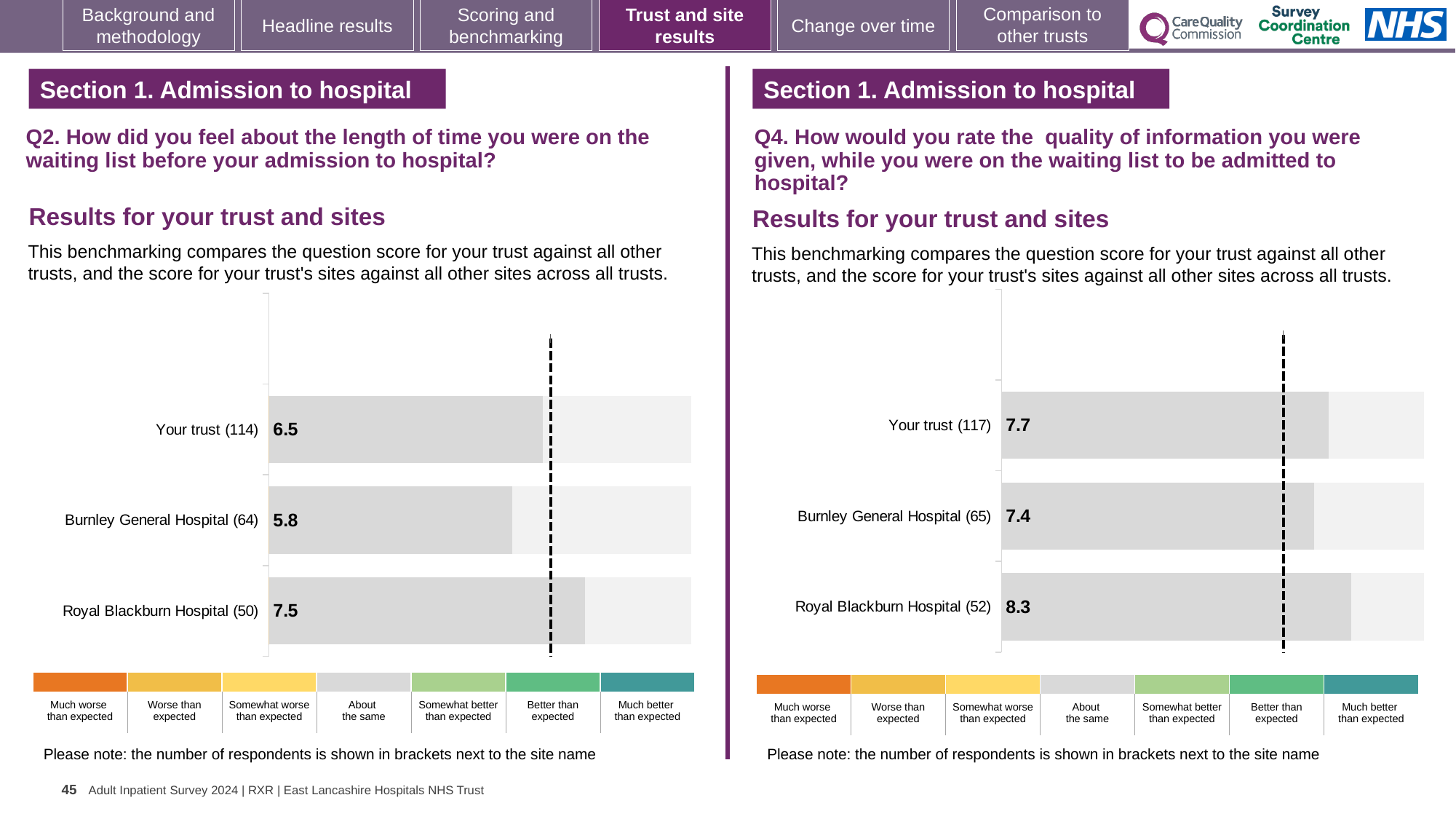
On the Q2 chart (left), what is the difference between the scores for Royal Blackburn Hospital (50) and Burnley General Hospital (64)? 1.7 On the Q2 chart (left), what is the score for Burnley General Hospital (64)? 5.8 On the Q4 chart (right), which site or trust has the lowest score? Burnley General Hospital (65) On the Q2 chart (left), which site or trust has the highest score? Royal Blackburn Hospital (50) On the Q4 chart (right), what is the score for Your trust (117)? 7.7 On the Q4 chart (right), which is larger: the score for Your trust (117) or Burnley General Hospital (65)? Your trust (117) On the Q2 chart (left), which site or trust has the lowest score? Burnley General Hospital (64) On the Q4 chart (right), what is the difference between the scores for Royal Blackburn Hospital (52) and Your trust (117)? 0.6 On the Q2 chart (left), what is the score for Your trust (114)? 6.5 On the Q4 chart (right), what is the score for Royal Blackburn Hospital (52)? 8.3 How many bars are plotted on the Q2 chart (left)? 3 What kind of chart is used on the Q4 chart (right)? Bar chart